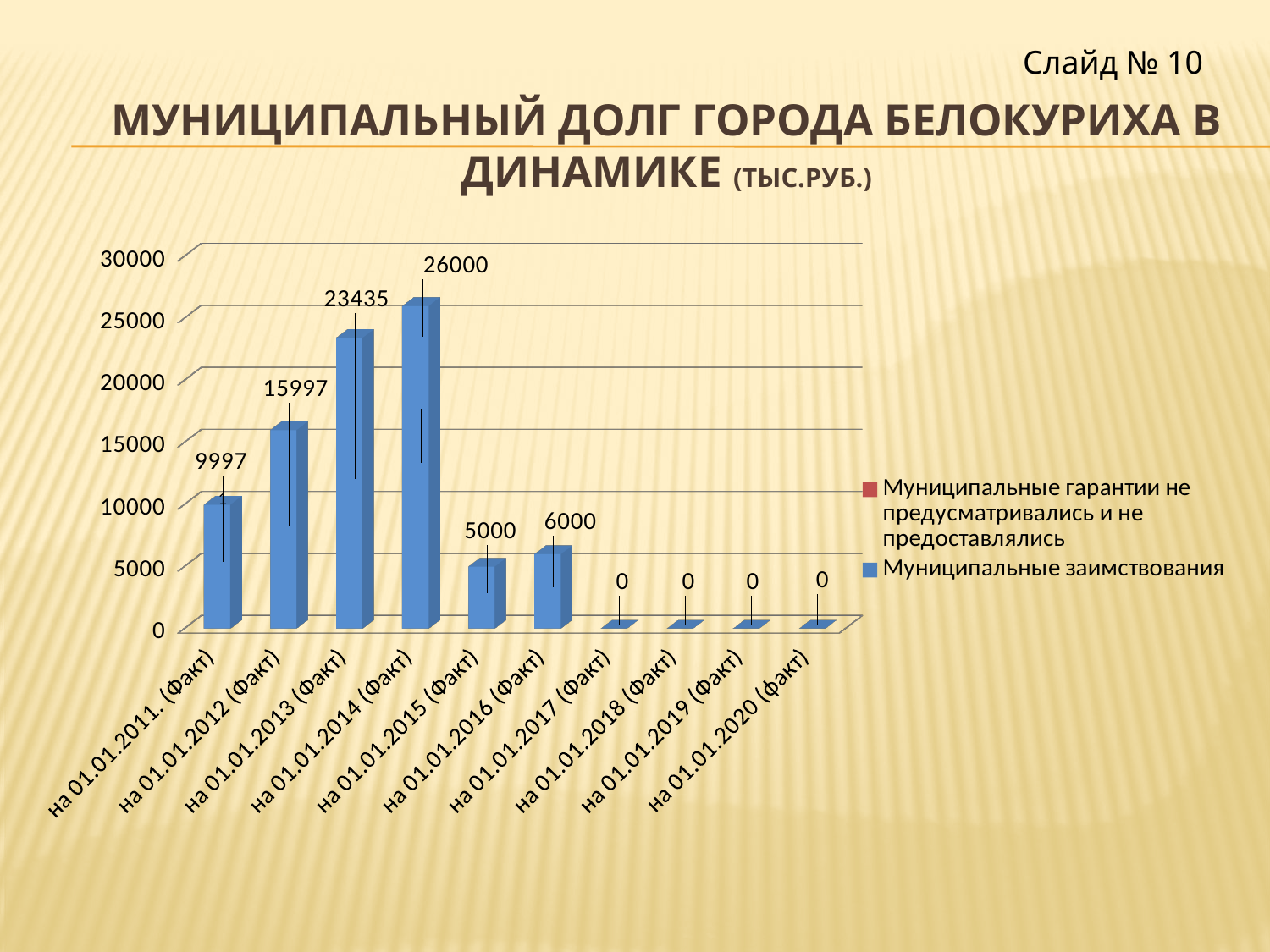
What is the value of municipal borrowings for на 01.01.2018 (Факт)? 0 Which is larger: municipal borrowings for на 01.01.2015 (Факт) or на 01.01.2016 (Факт)? на 01.01.2016 (Факт) What is the value of municipal borrowings for на 01.01.2016 (Факт)? 6000 How many series does the legend list? 2 What is the value of municipal borrowings (Муниципальные заимствования) for на 01.01.2014 (Факт)? 26000 How many dates (categories) are shown on the x axis? 10 What is the value of municipal borrowings for на 01.01.2011 (Факт)? 9997 Which date has the highest value of municipal borrowings? на 01.01.2014 (Факт) Do the municipal borrowings rise or fall from на 01.01.2014 (Факт) to на 01.01.2020 (Факт)? fall In what units are the values on the chart given, according to the title? тыс.руб. What kind of chart is shown on the slide? bar chart What is the difference between the municipal borrowings for на 01.01.2013 (Факт) and на 01.01.2012 (Факт)? 7438